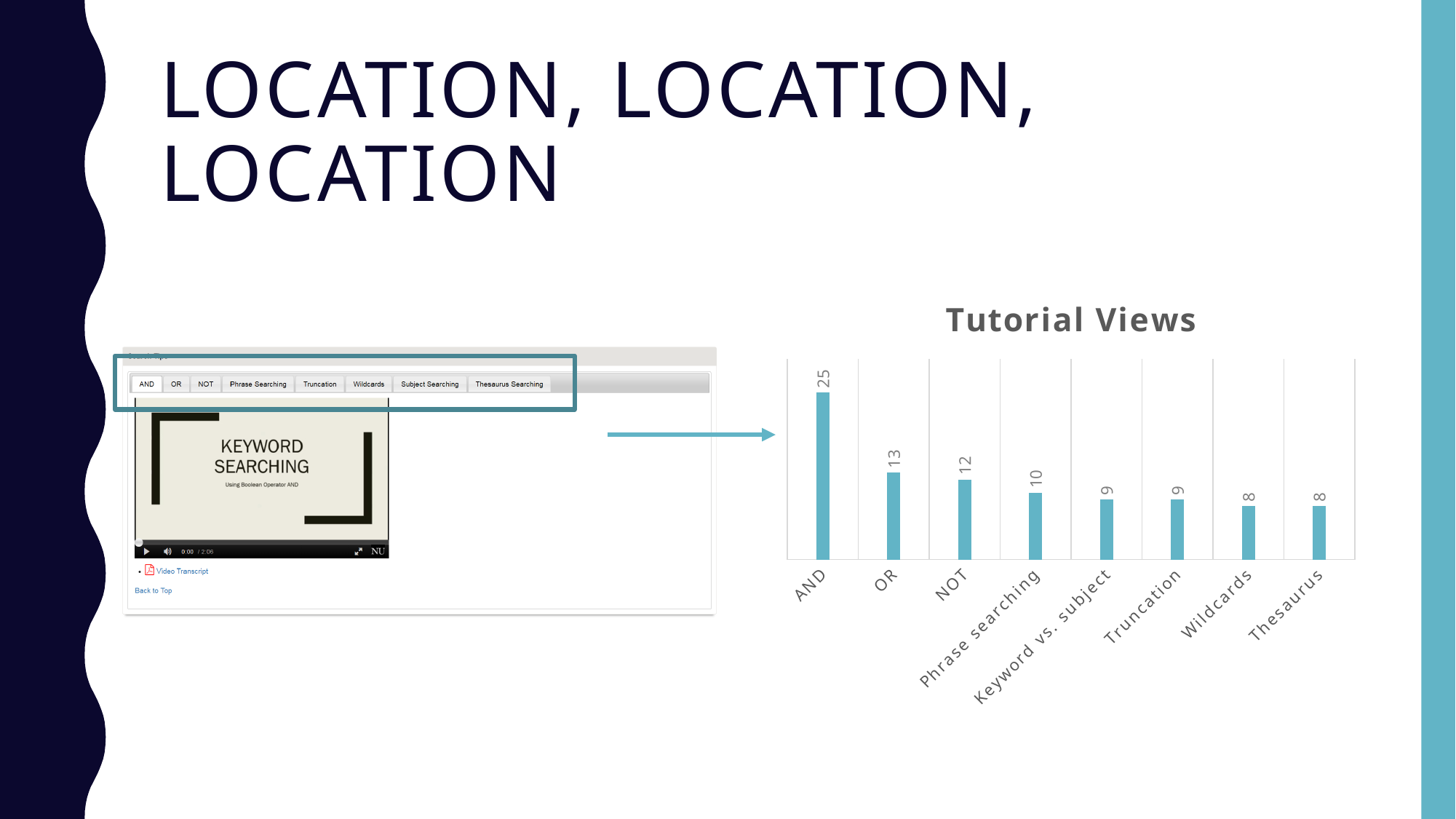
Do the values in the Tutorial Views chart rise or fall from left to right? fall What is the difference between the values for AND and OR in the Tutorial Views chart? 12 What is the value for AND in the Tutorial Views chart? 25 What is the title of the chart on the slide? Tutorial Views How many categories are shown in the Tutorial Views chart? 8 What is the value for Wildcards in the Tutorial Views chart? 8 What is the difference between the values for NOT and Thesaurus in the Tutorial Views chart? 4 What is the value for Phrase searching in the Tutorial Views chart? 10 Which category has the highest value in the Tutorial Views chart? AND What kind of chart is the Tutorial Views chart? bar chart Which is larger in the Tutorial Views chart, the value for OR or the value for Phrase searching? OR What is the value for Keyword vs. subject in the Tutorial Views chart? 9